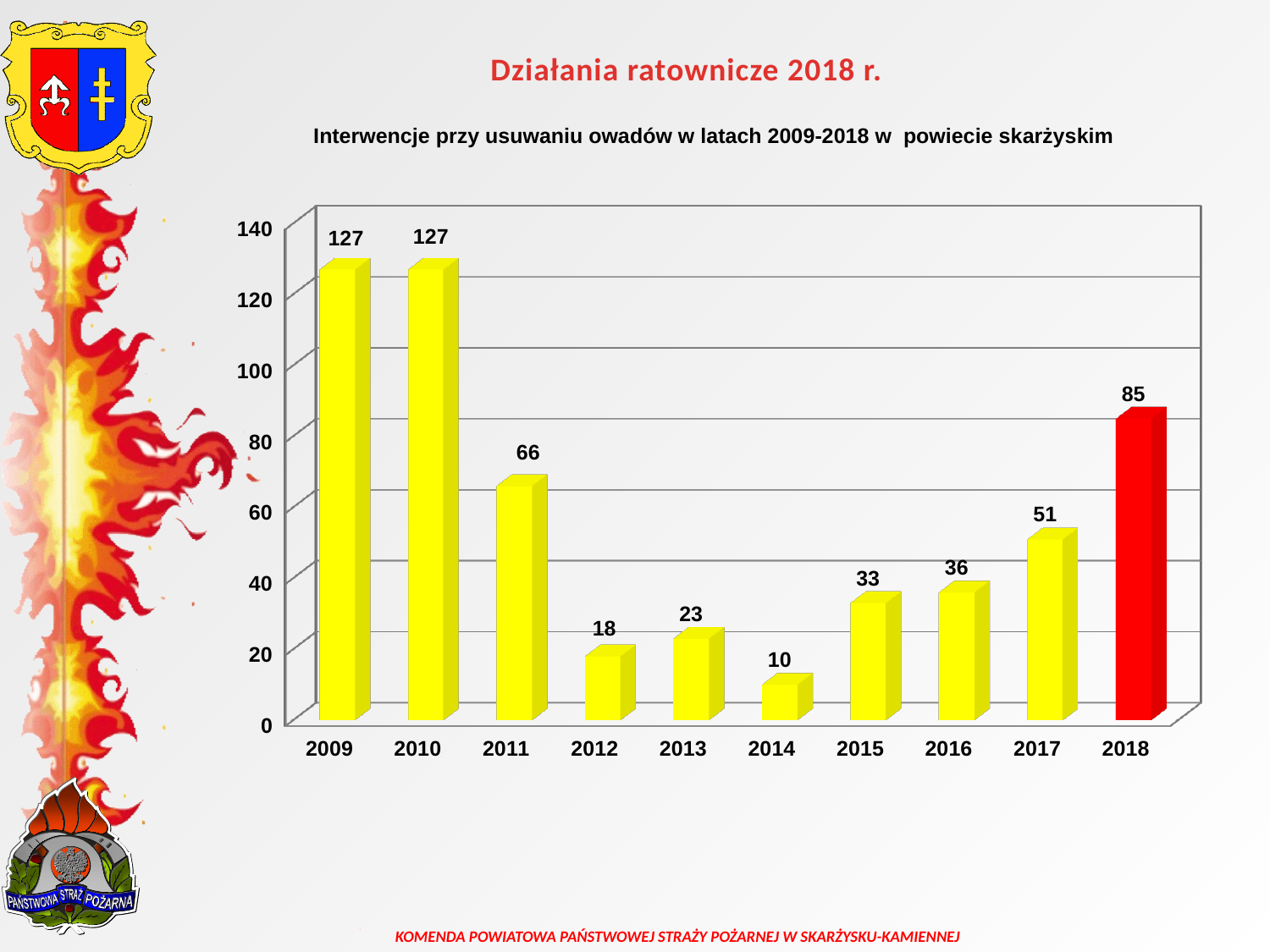
Which bar is coloured red rather than yellow? 2018 Which year has the lowest value? 2014 What is the difference between the values for 2018 and 2017? 34 What is the value for 2018? 85 Do the values rise or fall from 2014 to 2018? rise Is the value for 2013 greater or less than 40? less What is the difference between the values for 2011 and 2012? 48 What is the value for 2014? 10 Which is larger, the value for 2015 or the value for 2016? 2016 What kind of chart is shown on the slide? bar chart How many years are shown on the x axis? 10 What is the value for 2011? 66